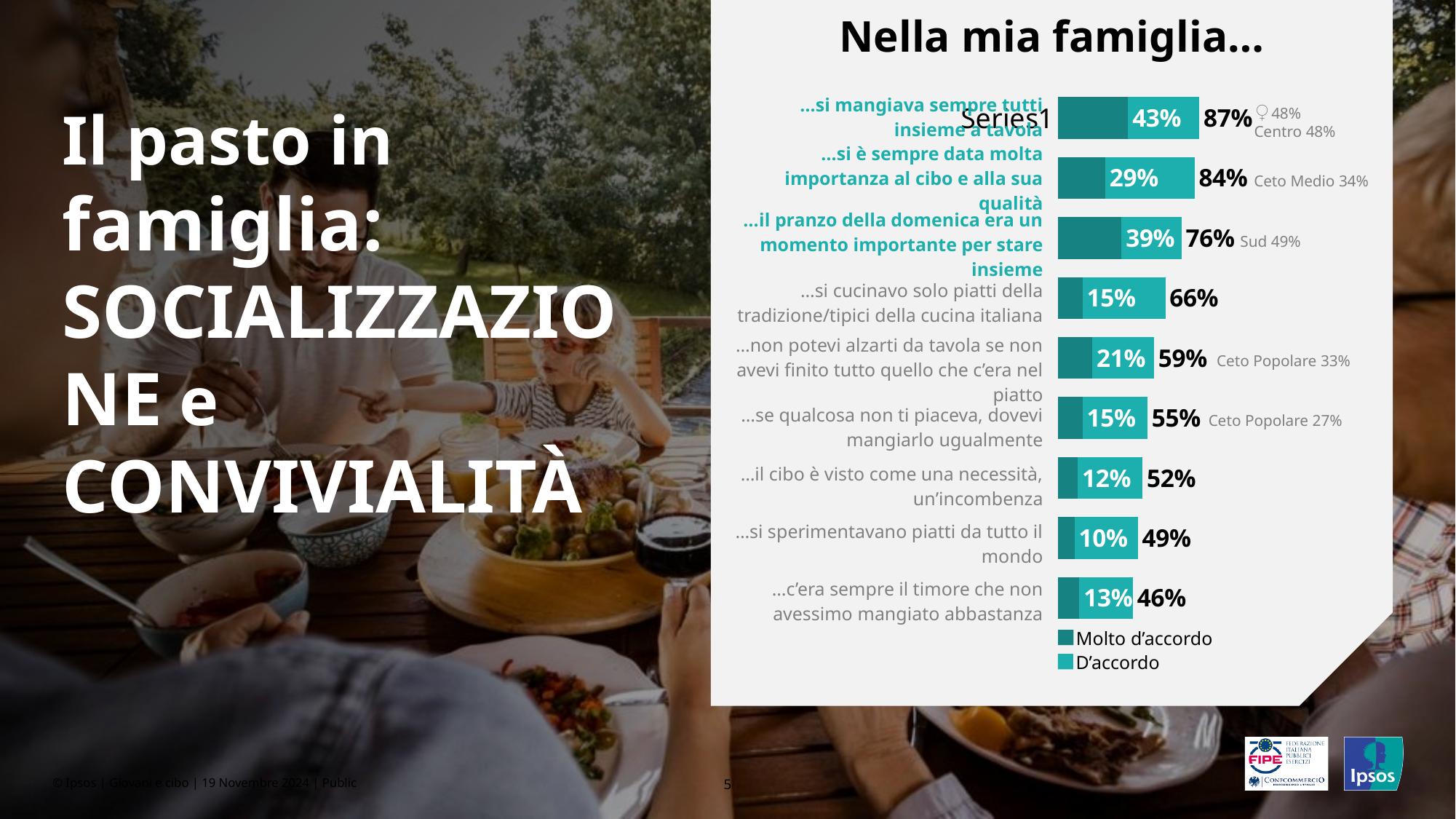
What is the difference between the total agreement for '…si è sempre data molta importanza al cibo e alla sua qualità' (84%) and '…il cibo è visto come una necessità, un'incombenza' (52%)? 32% How many series does the legend list? 2 How many categories (statements) are plotted in the chart? 9 What is the title of the chart? Nella mia famiglia… What is the 'Molto d'accordo' value for '…si sperimentavano piatti da tutto il mondo'? 10% Which statement has the highest total agreement percentage? …si mangiava sempre tutti insieme a tavola What kind of chart is shown on the slide? Stacked bar chart What is the 'Molto d'accordo' value for '…si mangiava sempre tutti insieme a tavola'? 43% Which statement has the lowest total agreement percentage? …c'era sempre il timore che non avessimo mangiato abbastanza What is the total agreement percentage shown for '…il pranzo della domenica era un momento importante per stare insieme'? 76% Which has a larger 'Molto d'accordo' value: '…non potevi alzarti da tavola se non avevi finito tutto quello che c'era nel piatto' or '…se qualcosa non ti piaceva, dovevi mangiarlo ugualmente'? …non potevi alzarti da tavola se non avevi finito tutto quello che c'era nel piatto Which legend entry is shown in the darker teal colour? Molto d'accordo